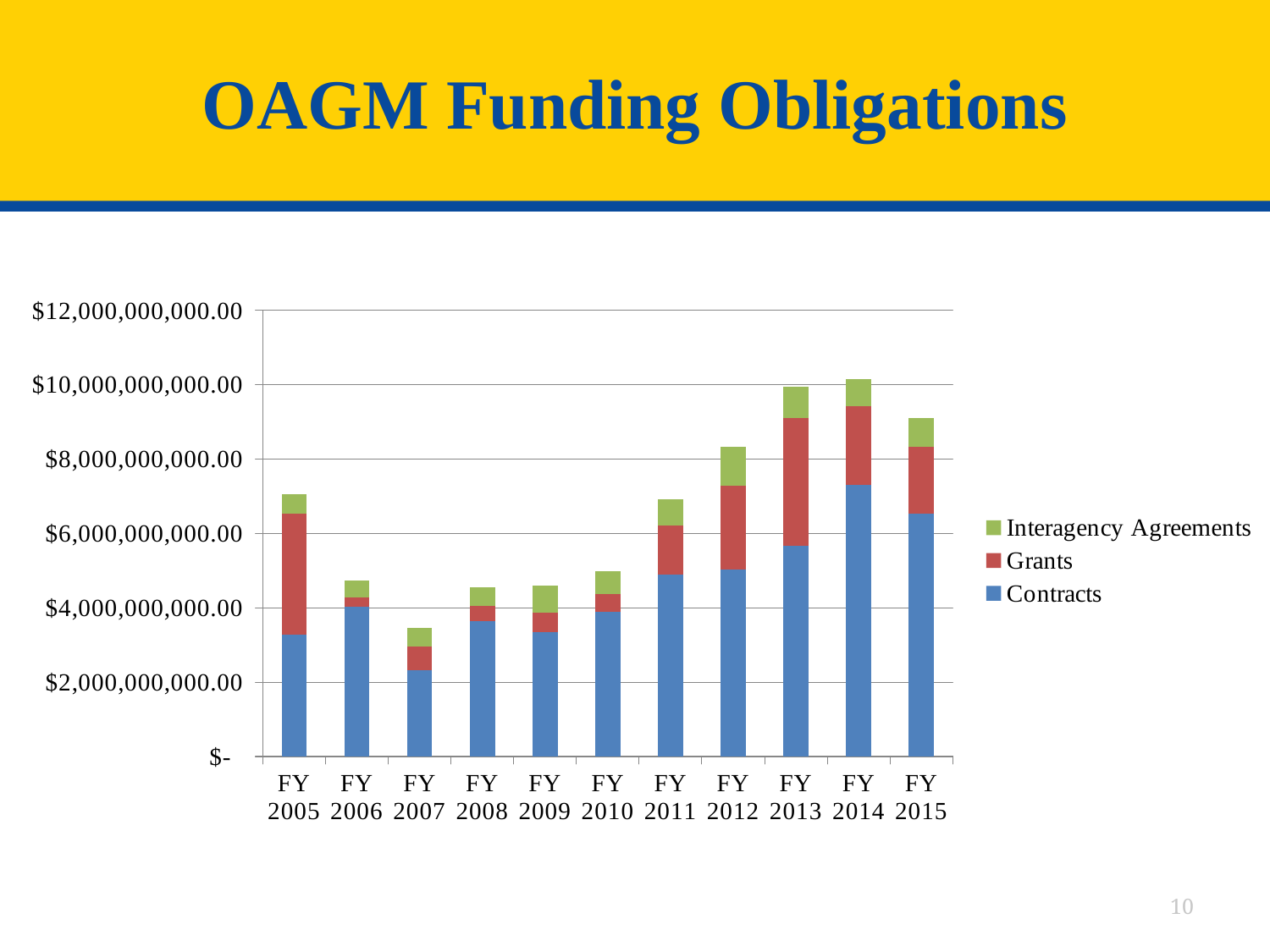
What kind of chart is shown on the slide? Stacked bar chart How many series does the legend list? 3 Which fiscal year has the largest Contracts segment? FY 2014 Do total funding obligations rise or fall from FY 2007 to FY 2014? Rise Which fiscal year has the highest total funding obligations? FY 2014 Is the total for FY 2007 greater or less than $4,000,000,000.00? less How many fiscal years are shown on the x axis? 11 Which has the larger total funding obligations, FY 2012 or FY 2013? FY 2013 Is the total for FY 2012 greater or less than $8,000,000,000.00? greater Is the Contracts value for FY 2014 greater or less than $6,000,000,000.00? greater Which fiscal year has the lowest total funding obligations? FY 2007 What colour represents Contracts in the chart? Blue